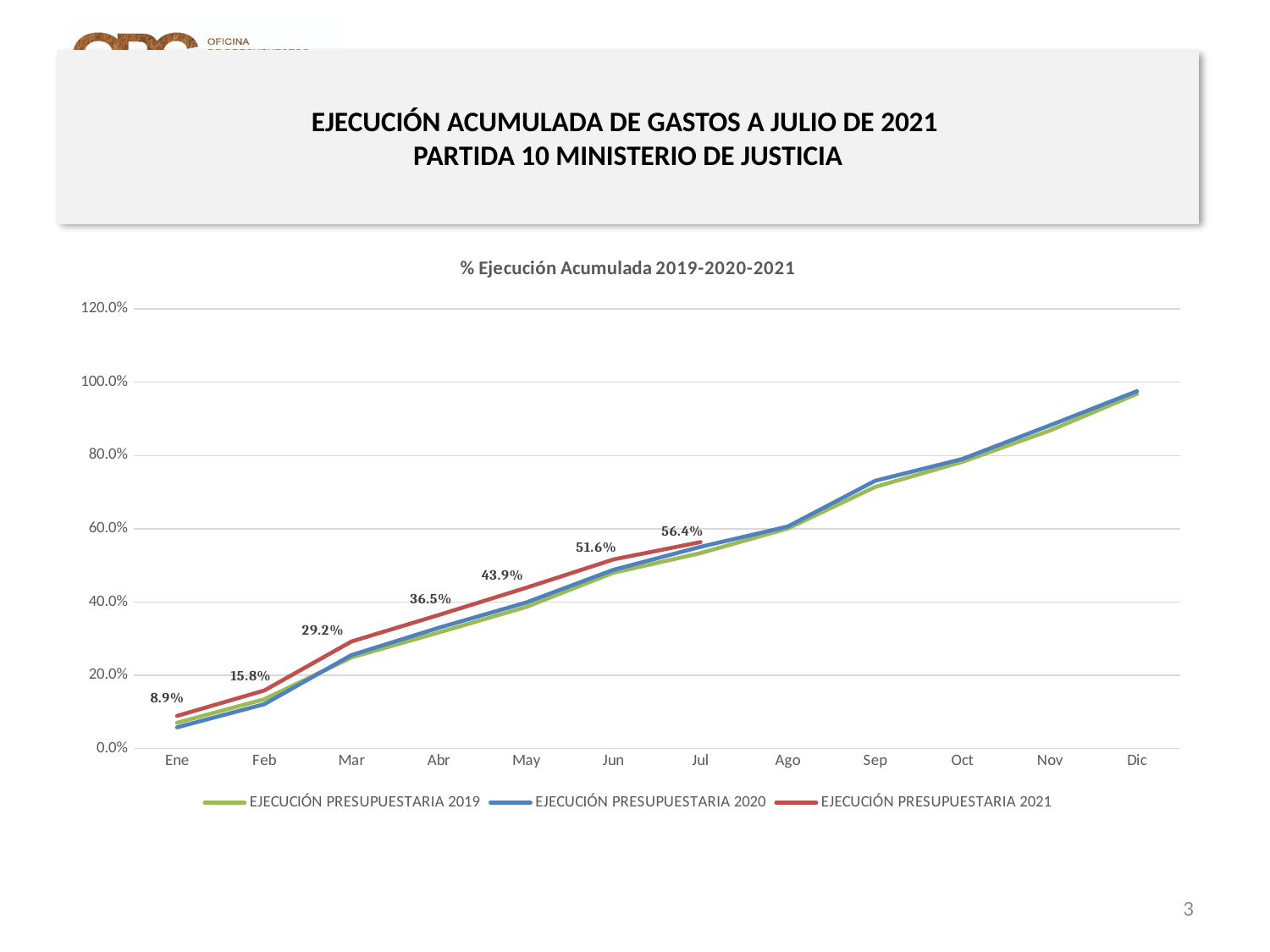
Do the values for EJECUCIÓN PRESUPUESTARIA 2019 rise or fall from Ene to Dic? Rise What kind of chart is shown on the slide? Line chart What is the value for EJECUCIÓN PRESUPUESTARIA 2021 in Abr? 36.5% What is the value for EJECUCIÓN PRESUPUESTARIA 2021 in Ene? 8.9% What is the value for EJECUCIÓN PRESUPUESTARIA 2021 in Jul? 56.4% What is the difference between the EJECUCIÓN PRESUPUESTARIA 2021 values for Mar and Feb? 13.4% How many series does the legend list? 3 Is the value for EJECUCIÓN PRESUPUESTARIA 2020 in Dic greater or less than 80.0%? greater What is the difference between the EJECUCIÓN PRESUPUESTARIA 2021 values for Jun and May? 7.7% What is the value for EJECUCIÓN PRESUPUESTARIA 2021 in Mar? 29.2% Which month has the highest value for EJECUCIÓN PRESUPUESTARIA 2021? Jul Which month has the lowest value for EJECUCIÓN PRESUPUESTARIA 2021? Ene